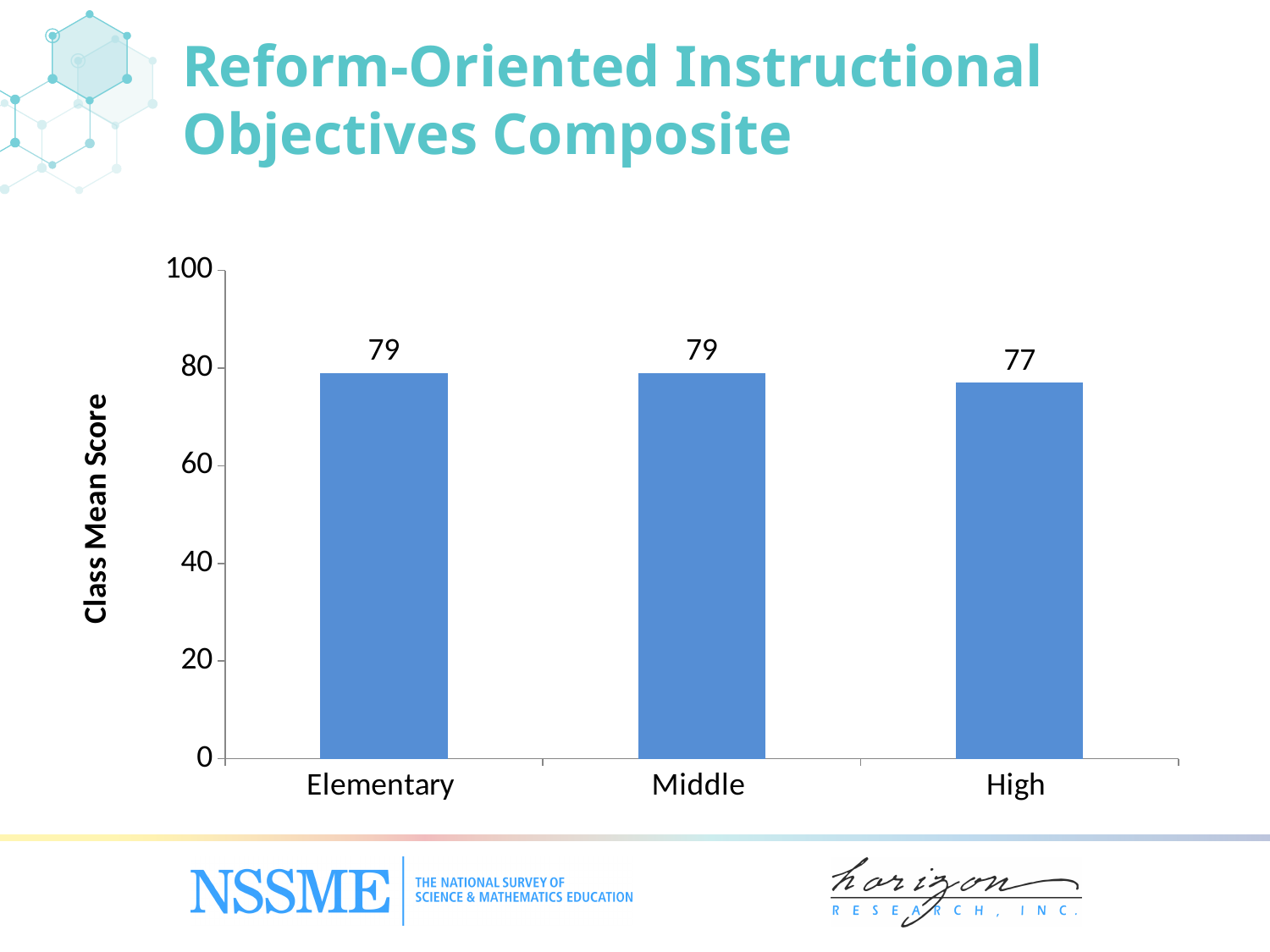
Which category has the lowest class mean score? High What is the label of the y axis? Class Mean Score How many categories are shown on the x axis? 3 Is the value for High greater or less than 80? less Which is larger, the class mean score for Middle or for High? Middle What is the class mean score for Elementary? 79 What is the maximum value shown on the y axis? 100 Do the values rise or fall from Middle to High? fall What is the difference between the class mean scores for Elementary and High? 2 What is the class mean score for High? 77 What kind of chart is shown on the slide? bar chart What is the class mean score for Middle? 79